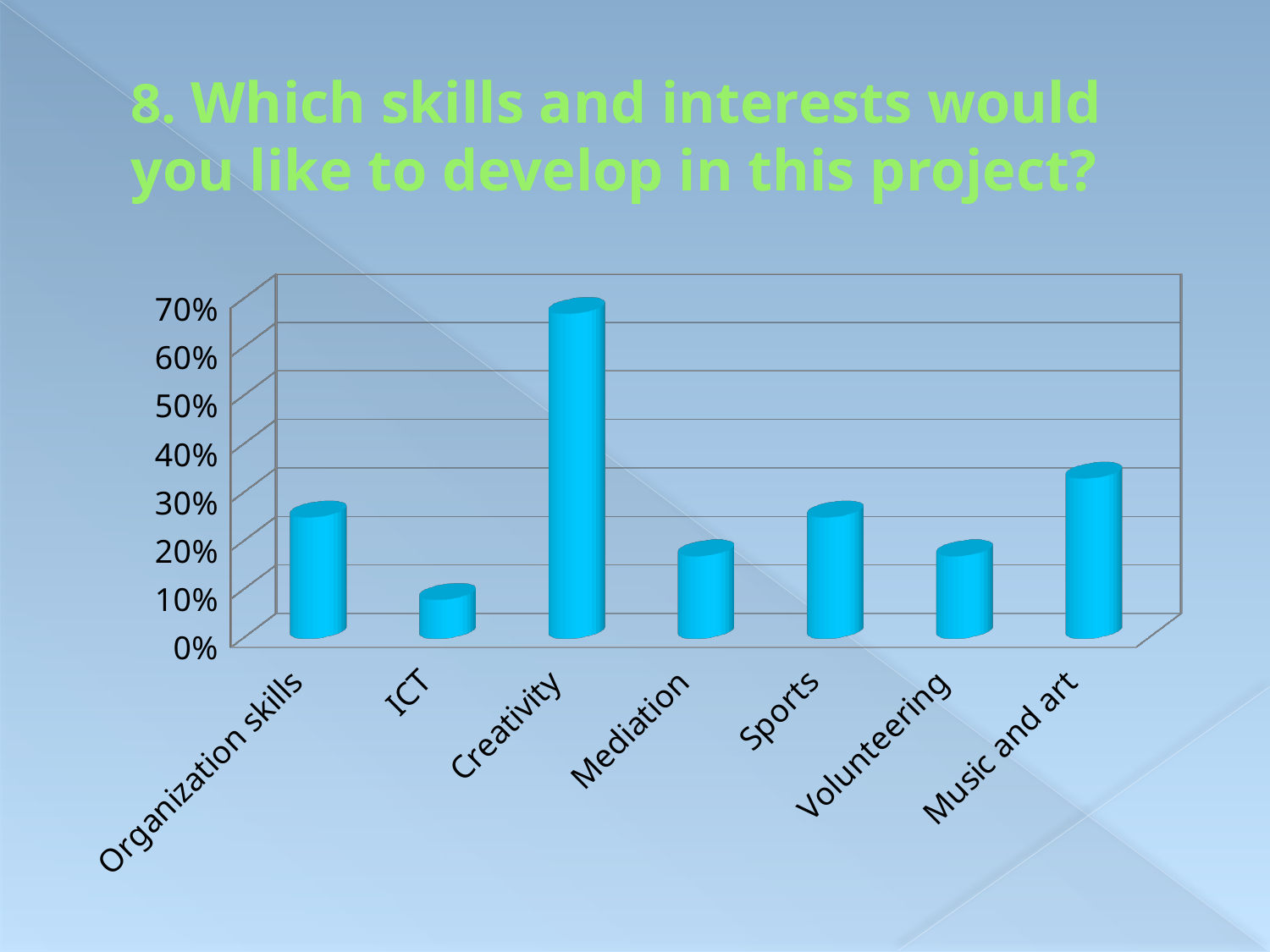
What kind of chart is shown on the slide? bar chart Is the value for Music and art greater or less than 30%? greater Is the value for Organization skills greater or less than 20%? greater Which is larger, the value for Music and art or the value for Sports? Music and art Is the value for Creativity greater or less than 60%? greater Which is larger, the value for Creativity or the value for Music and art? Creativity Which category has the highest value in the chart? Creativity What is the title of the chart on the slide? 8. Which skills and interests would you like to develop in this project? How many categories are shown on the x axis of the chart? 7 Which category has the lowest value in the chart? ICT